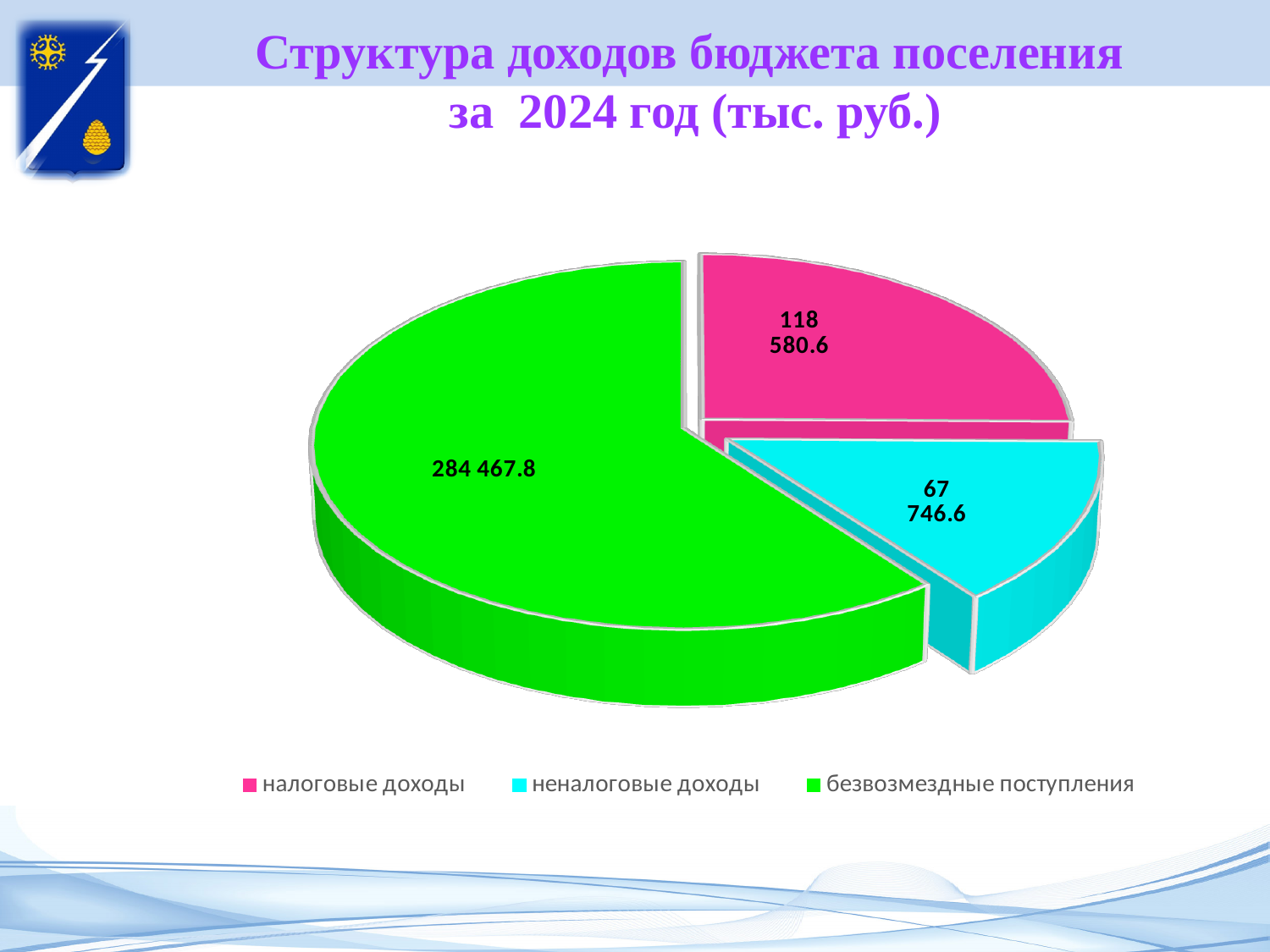
What is the difference between безвозмездные поступления and налоговые доходы? 165 887.2 How many slices does the pie chart have? 3 Which category has the largest slice of the pie? безвозмездные поступления What is the value for неналоговые доходы? 67 746.6 Which is larger, налоговые доходы or неналоговые доходы? налоговые доходы Which category has the smallest slice of the pie? неналоговые доходы What is the value for безвозмездные поступления? 284 467.8 What is the difference between налоговые доходы and неналоговые доходы? 50 834 What is the value for налоговые доходы? 118 580.6 What kind of chart is shown on the slide? pie chart What colour is the slice for безвозмездные поступления? green What is the total of all three slices? 470 795